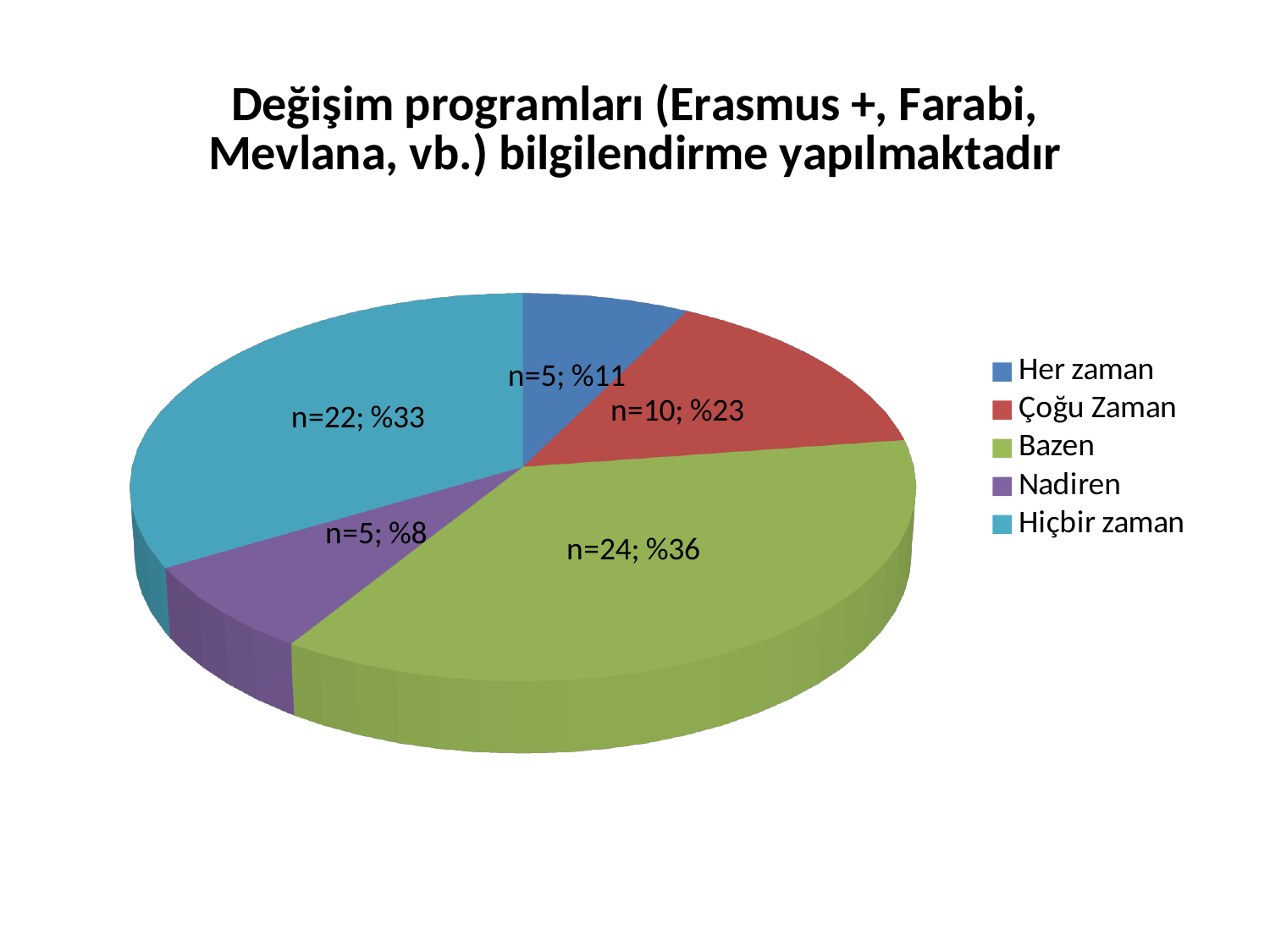
Which category has the smallest percentage share? Nadiren What is the difference in count (n) between Bazen and Hiçbir zaman? 2 Which is larger, the count for Hiçbir zaman or the count for Çoğu Zaman? Hiçbir zaman How many entries does the legend list? 5 What kind of chart is shown on the slide? Pie chart What percentage is shown for the Her zaman slice? %11 Which category has the largest slice? Bazen What is the data label for the Çoğu Zaman slice? n=10; %23 What percentage is shown for the Nadiren slice? %8 How many slices does the pie chart have? 5 What is the data label for the Bazen slice? n=24; %36 What is the data label for the Hiçbir zaman slice? n=22; %33